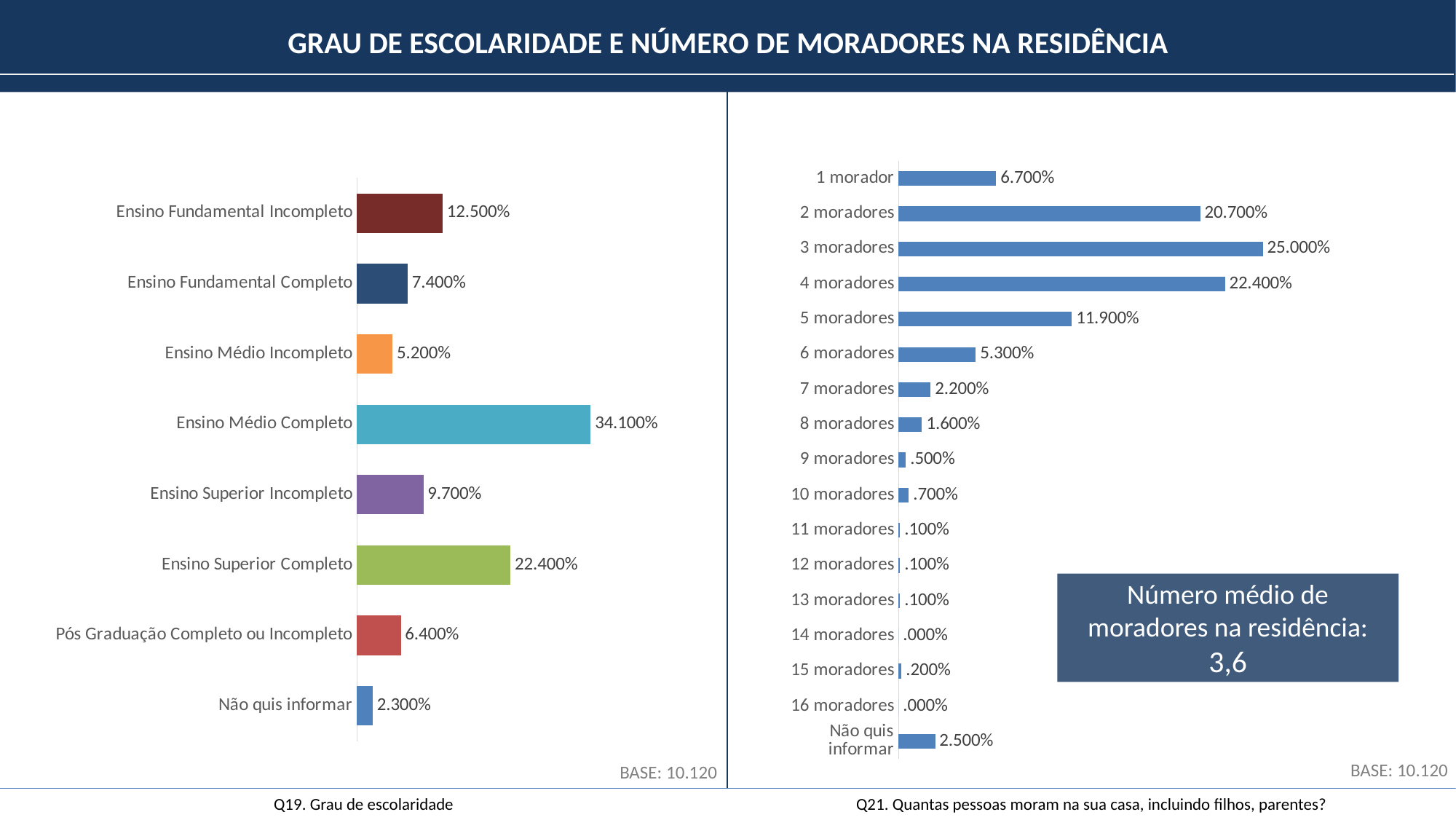
In the left chart (Grau de escolaridade), what is the value for Ensino Médio Completo? 34.100% In the right chart (número de moradores), what is the value for 4 moradores? 22.400% In the left chart (Grau de escolaridade), what is the difference between Ensino Superior Completo and Ensino Superior Incompleto? 12.700% In the right chart (número de moradores), which category has the highest value? 3 moradores What kind of chart is the left chart (Grau de escolaridade)? Bar chart In the right chart (número de moradores), which is larger: 5 moradores or 6 moradores? 5 moradores In the right chart (número de moradores), what is the difference between 2 moradores and 1 morador? 14.000% In the right chart (número de moradores), how many categories are shown? 17 What is the average number of residents per household stated in the box on the right side of the slide? 3,6 In the left chart (Grau de escolaridade), which category has the lowest value? Não quis informar In the left chart (Grau de escolaridade), which is larger: Ensino Fundamental Incompleto or Ensino Fundamental Completo? Ensino Fundamental Incompleto In the left chart (Grau de escolaridade), how many categories are shown? 8